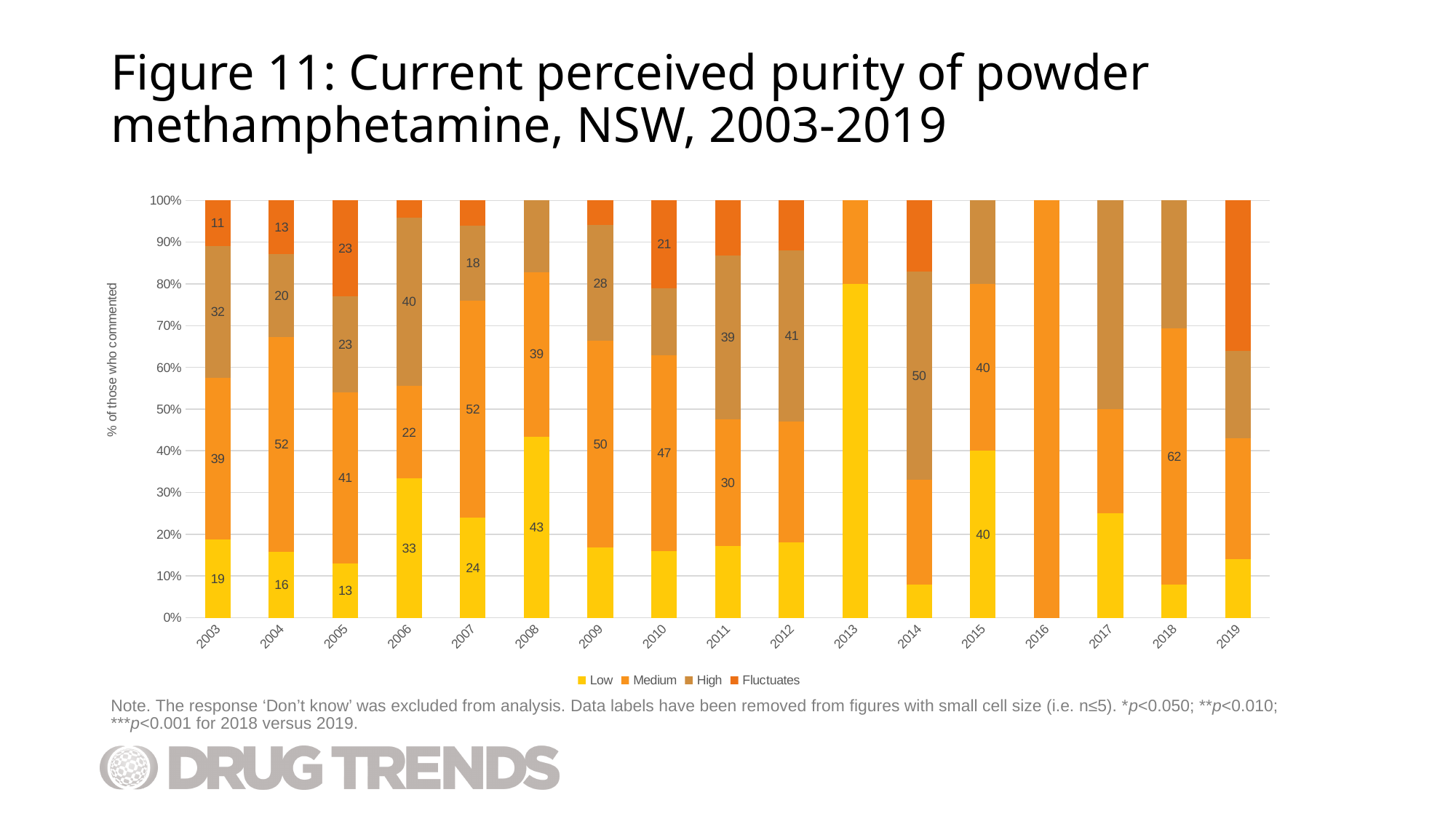
What is the value of the Low segment for 2003? 19 How many series does the legend list? 4 Which year has the larger Low segment, 2007 or 2008? 2008 What is the value of the Medium segment for 2018? 62 What is the value of the Medium segment for 2004? 52 Is the Low segment for 2013 greater or less than 70%? greater Which segment is the largest in the 2003 bar? Medium In 2005, what is the difference between the Medium segment and the High segment? 18 How many years are shown along the x axis of the chart? 17 What is the value of the High segment for 2006? 40 What kind of chart is shown on the slide? Stacked bar chart What is the value of the Fluctuates segment for 2010? 21